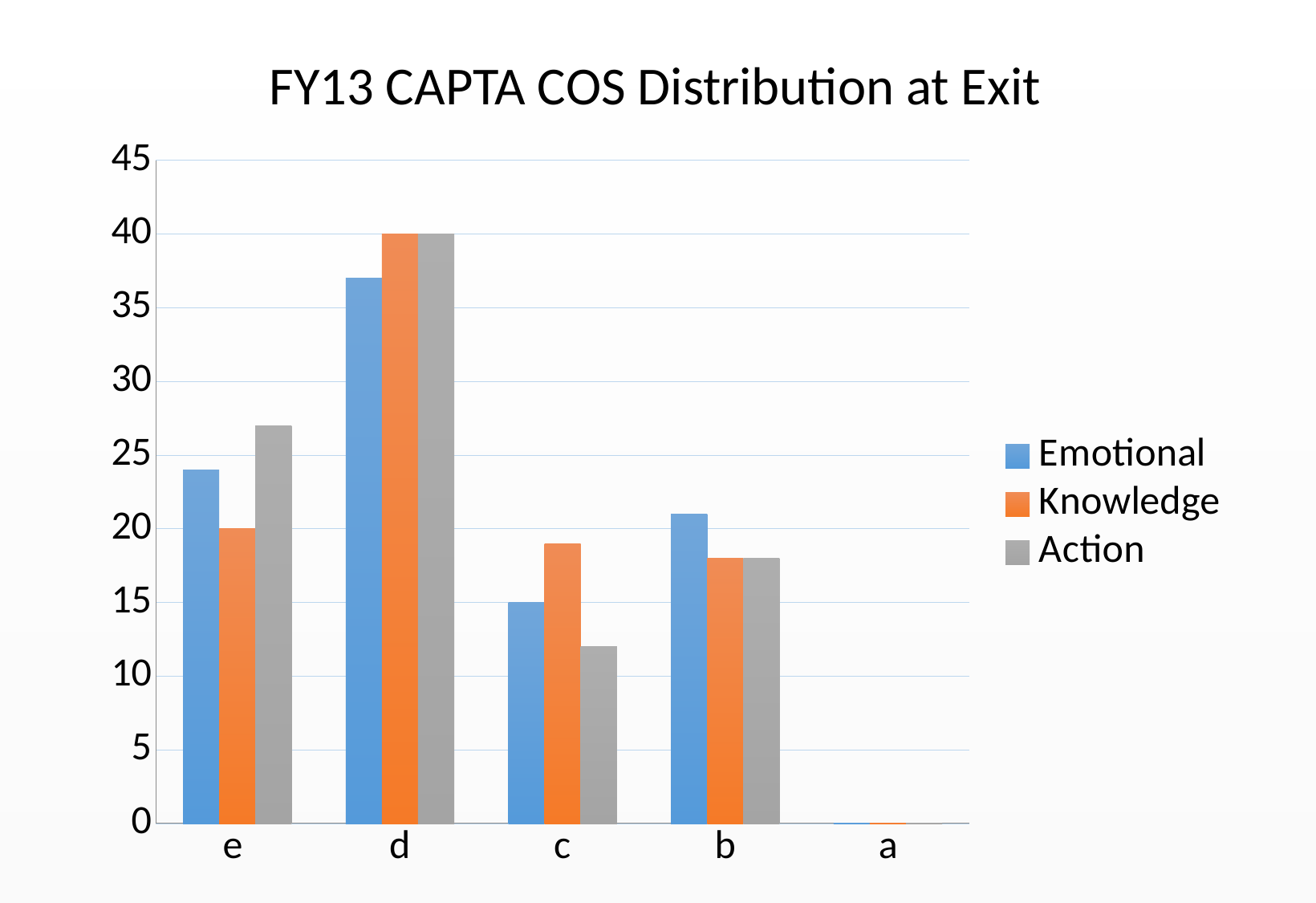
Which category has the highest Emotional value? d What is the Emotional value for category c? 15 How many series does the legend list? 3 What is the Action value for category d? 40 Which category has the lowest Action value? a Is the Action value for category c greater or less than 15? less What kind of chart is shown on the slide? bar chart For category b, which is larger, the Emotional value or the Knowledge value? Emotional How many categories are shown on the x axis? 5 What is the Knowledge value for category d? 40 Is the Action value for category e greater or less than 25? greater What is the Knowledge value for category e? 20